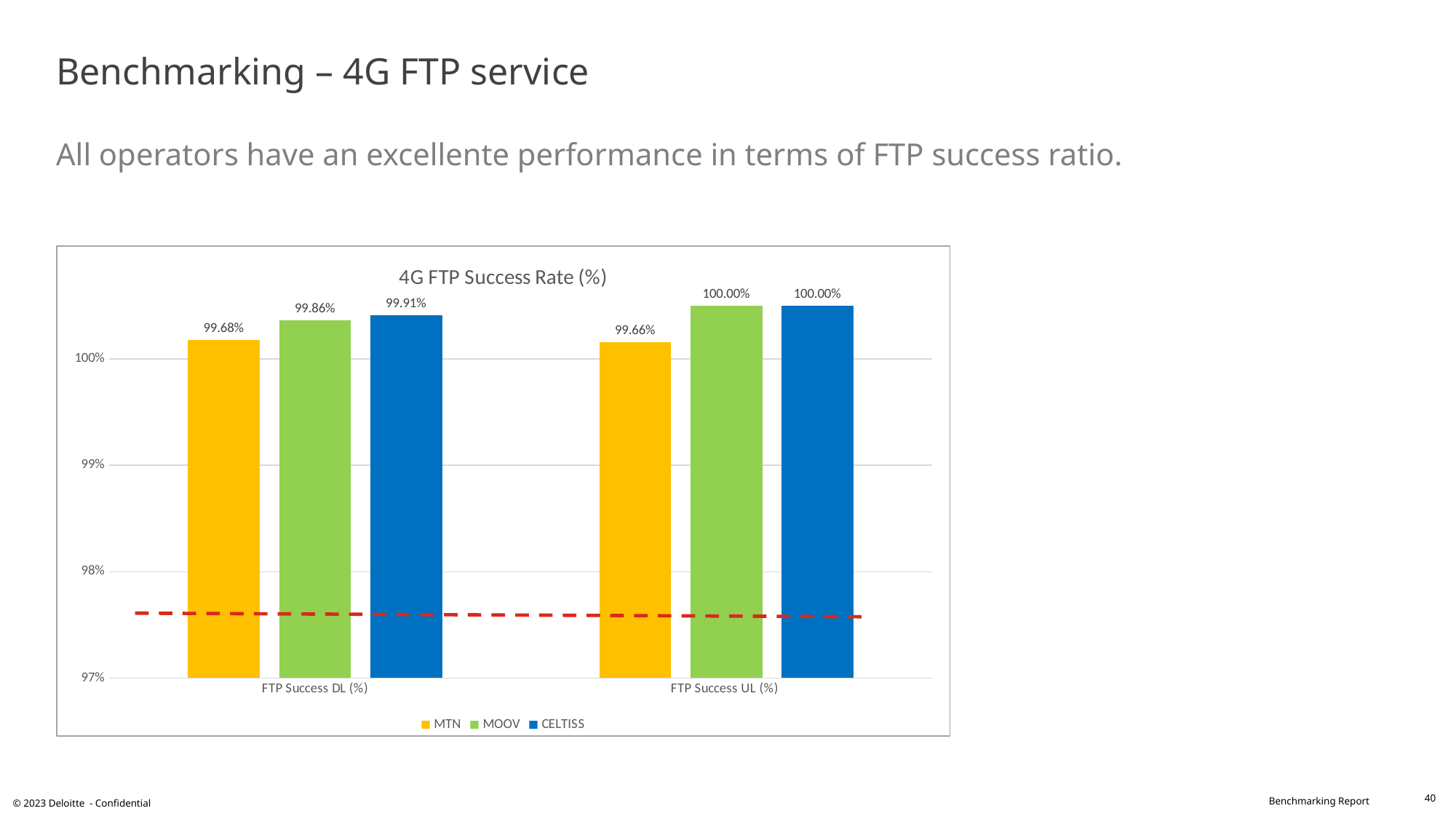
Which is larger: the MOOV value for FTP Success DL (%) or the MOOV value for FTP Success UL (%)? FTP Success UL (%) What is the MTN value for FTP Success UL (%)? 99.66% What kind of chart is shown on the slide? Bar chart Which operator has the lowest value for FTP Success DL (%)? MTN How many series does the legend list? 3 What is the difference between the MOOV and MTN values for FTP Success UL (%)? 0.34% What is the difference between the CELTISS and MTN values for FTP Success DL (%)? 0.23% What is the CELTISS value for FTP Success DL (%)? 99.91% Which operator has the highest value for FTP Success DL (%)? CELTISS What is the MOOV value for FTP Success UL (%)? 100.00% What is the MTN value for FTP Success DL (%)? 99.68% What is the title of the chart? 4G FTP Success Rate (%)